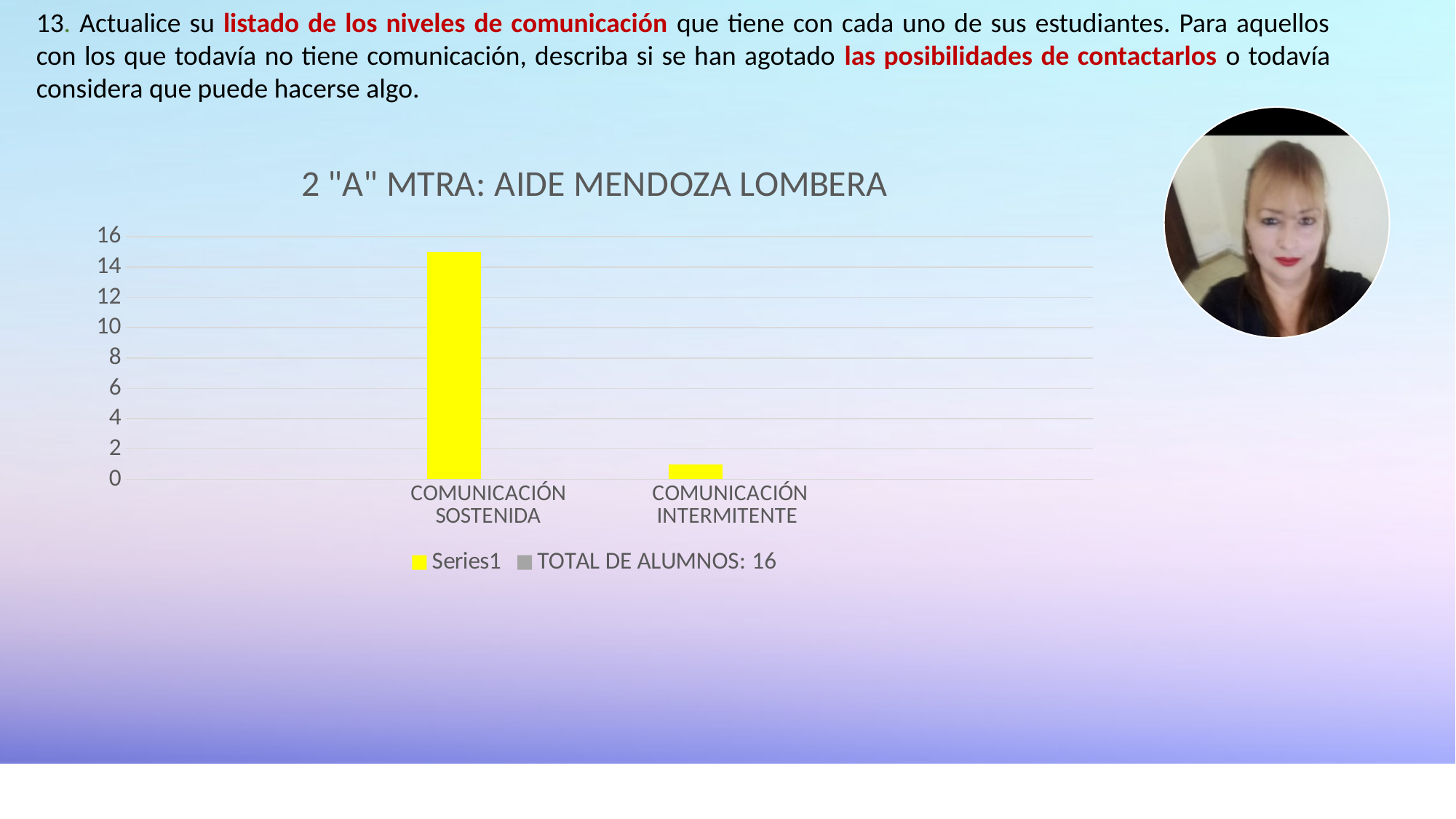
How many categories are shown on the x axis of the chart? 2 What kind of chart is shown on the slide? bar chart Which category has the lowest bar in the chart? COMUNICACIÓN INTERMITENTE Is the value for COMUNICACIÓN SOSTENIDA greater or less than 10? greater What is the title of the chart? 2 "A" MTRA: AIDE MENDOZA LOMBERA Is the value for COMUNICACIÓN INTERMITENTE greater or less than 4? less Which category has the highest bar in the chart? COMUNICACIÓN SOSTENIDA Is the value for COMUNICACIÓN SOSTENIDA greater or less than 16? less Which is larger, the value for COMUNICACIÓN SOSTENIDA or the value for COMUNICACIÓN INTERMITENTE? COMUNICACIÓN SOSTENIDA How many series does the chart legend list? 2 What colour are the bars in the chart? yellow Do the bar values rise or fall from left to right along the x axis? fall